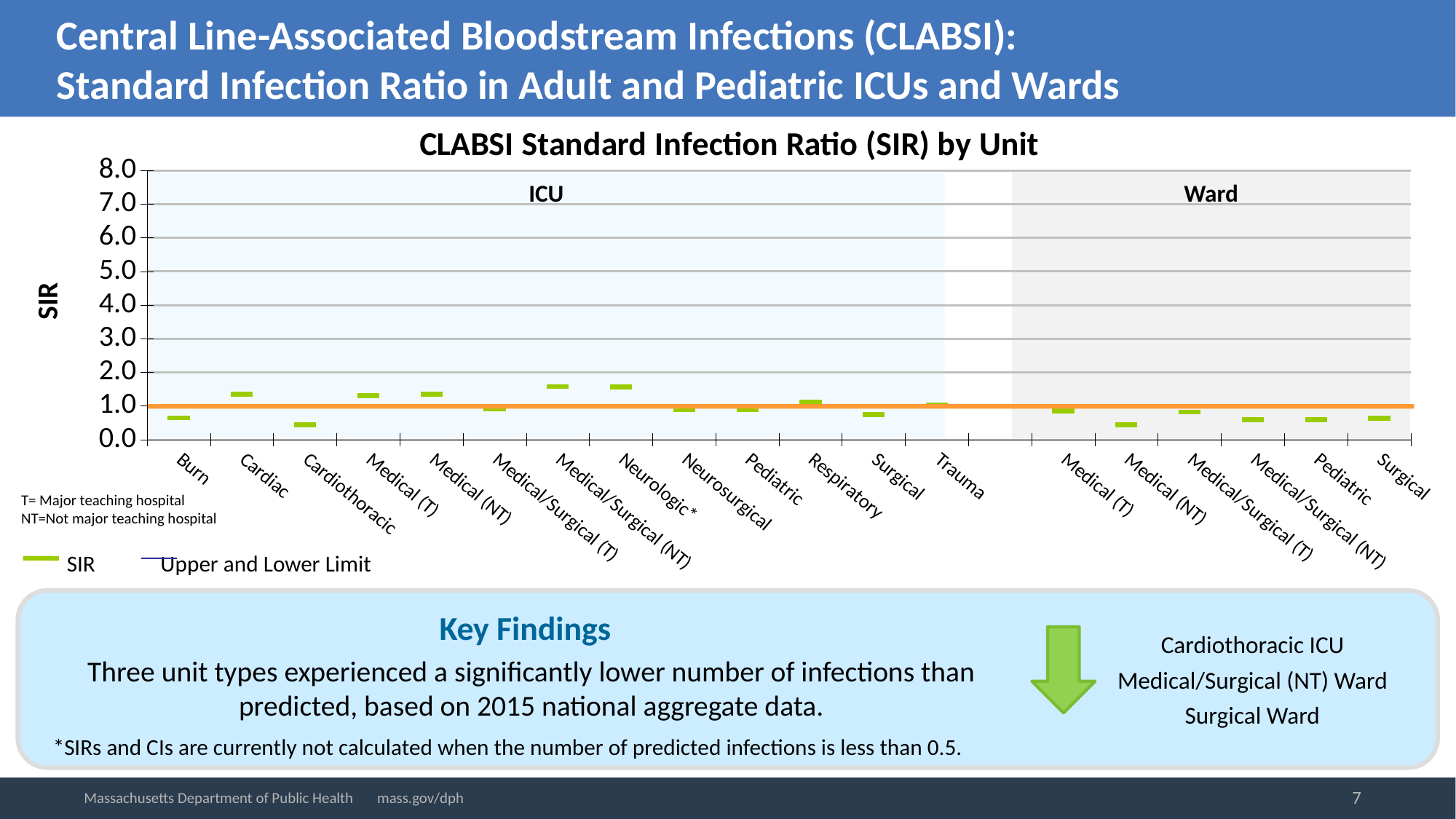
Is the SIR value for the Cardiothoracic ICU greater or less than 1.0? less How many unit categories are shown on the x axis of the chart? 19 How many unit categories are in the ICU section of the chart? 13 Is the SIR value for the Burn ICU greater or less than 1.0? less What is the title of the chart? CLABSI Standard Infection Ratio (SIR) by Unit Which has the larger SIR value, the Cardiac ICU or the Burn ICU? Cardiac ICU How many unit categories are in the Ward section of the chart? 6 What are the two entries in the chart legend? SIR; Upper and Lower Limit Is the SIR value for the Cardiac ICU greater or less than 2.0? less How many series does the chart legend list? 2 Which has the larger SIR value, the Medical/Surgical (T) ICU or the Pediatric Ward? Medical/Surgical (T) ICU